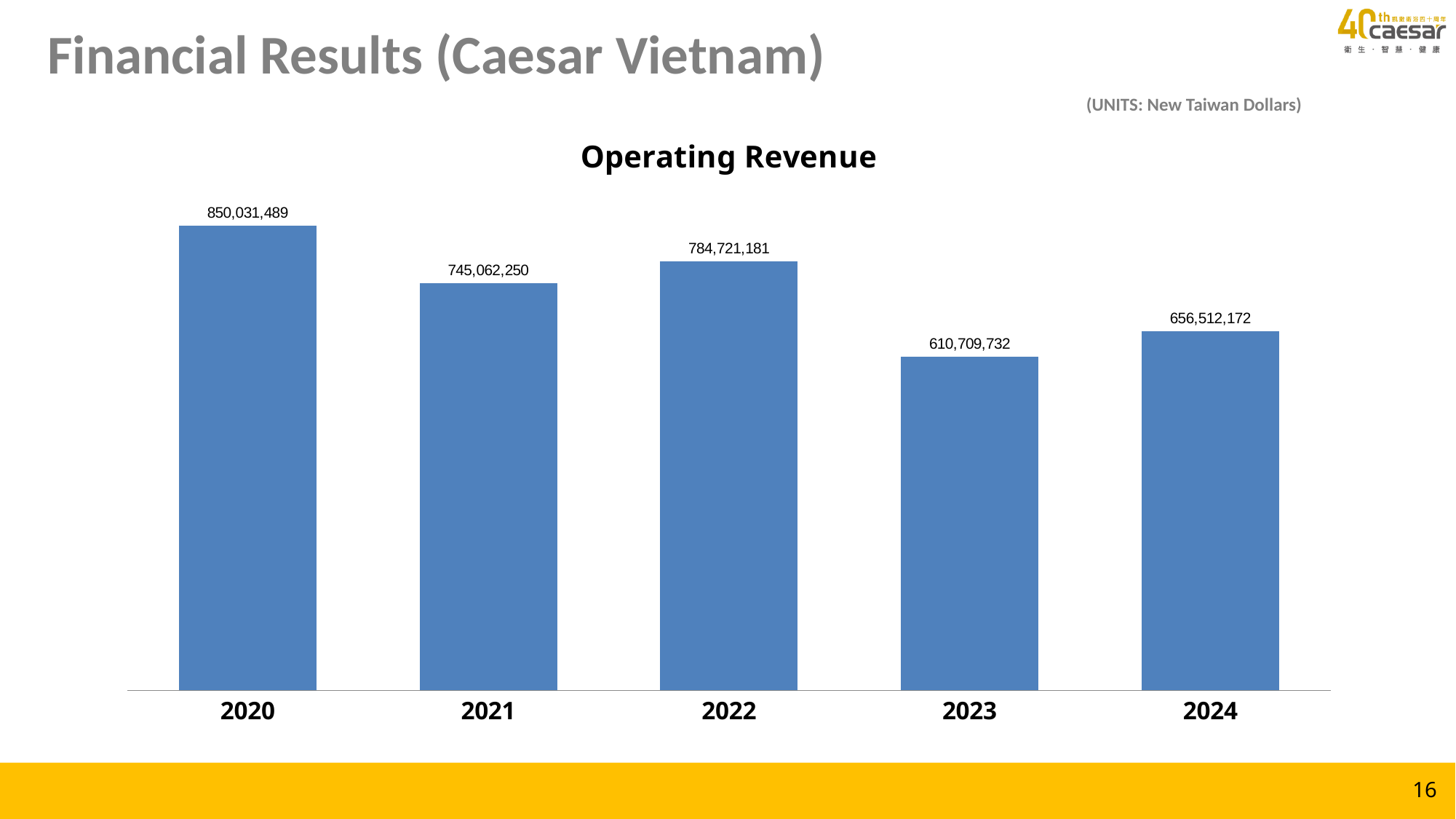
What unit is the operating revenue reported in? New Taiwan Dollars Which year had higher operating revenue, 2021 or 2022? 2022 What was the operating revenue in 2024? 656,512,172 By how much did operating revenue fall from 2022 to 2023? 174,011,449 What is the difference in operating revenue between 2020 and 2021? 104,969,239 What was the operating revenue in 2023? 610,709,732 What type of chart is used to show operating revenue? Bar chart Which year had the lowest operating revenue? 2023 By how much did operating revenue increase from 2023 to 2024? 45,802,440 How many years are shown on the chart? 5 What was the operating revenue in 2020? 850,031,489 Which year had the highest operating revenue? 2020